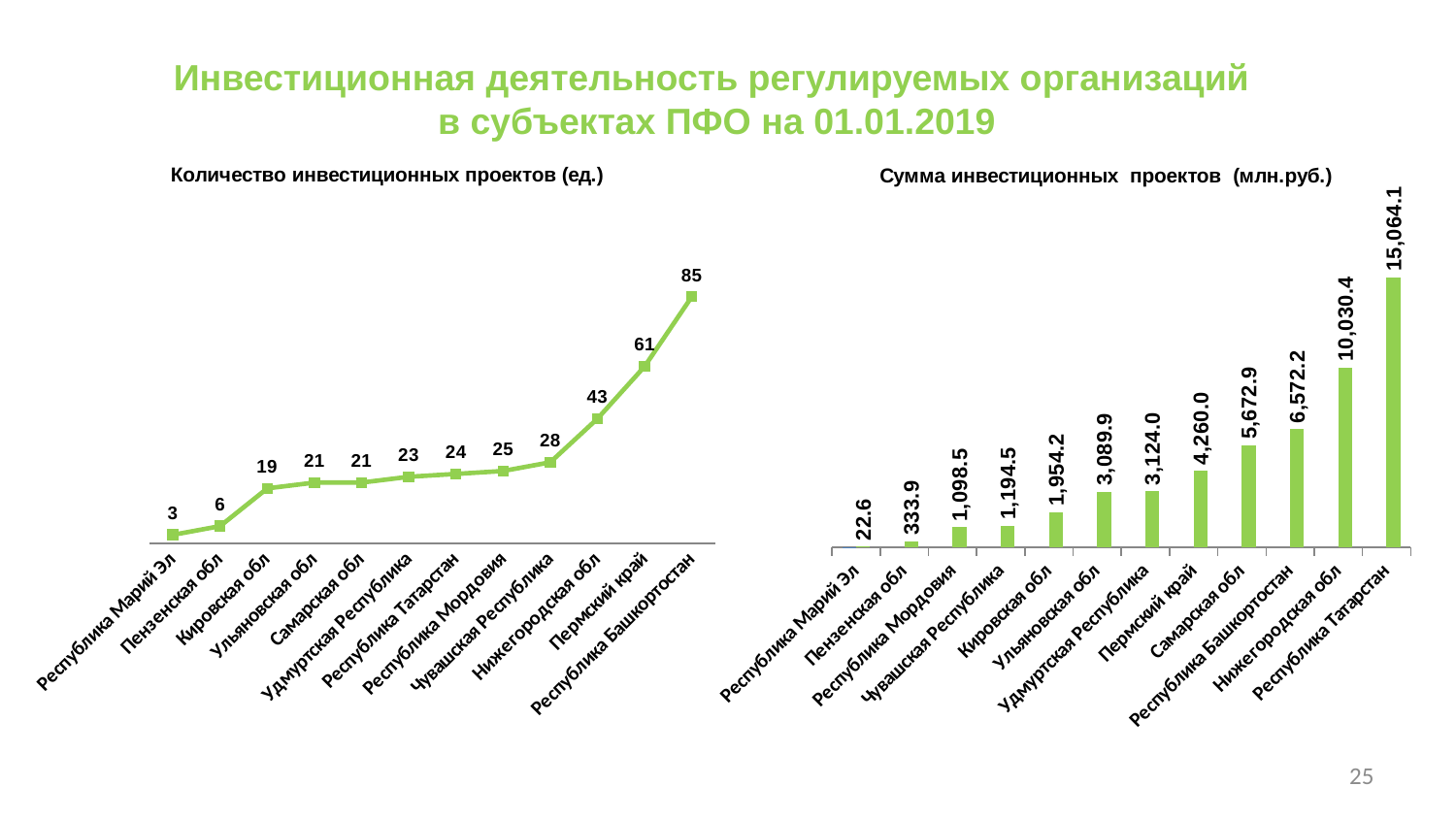
In the chart 'Сумма инвестиционных проектов (млн.руб.)', which region has the highest value? Республика Татарстан In the chart 'Количество инвестиционных проектов (ед.)', what is the value for Пермский край? 61 What type of chart is 'Количество инвестиционных проектов (ед.)'? line chart In the chart 'Количество инвестиционных проектов (ед.)', do the values rise or fall from left to right? rise In the chart 'Количество инвестиционных проектов (ед.)', what is the difference between Республика Башкортостан and Нижегородская обл? 42 In the chart 'Сумма инвестиционных проектов (млн.руб.)', what is the value for Республика Марий Эл? 22.6 In the chart 'Количество инвестиционных проектов (ед.)', which region has the highest value? Республика Башкортостан In the chart 'Количество инвестиционных проектов (ед.)', how many regions are plotted? 12 What type of chart is 'Сумма инвестиционных проектов (млн.руб.)'? bar chart In the chart 'Количество инвестиционных проектов (ед.)', which region has the lowest value? Республика Марий Эл In the chart 'Сумма инвестиционных проектов (млн.руб.)', which is larger: Пермский край or Удмуртская Республика? Пермский край In the chart 'Сумма инвестиционных проектов (млн.руб.)', what is the value for Самарская обл? 5,672.9